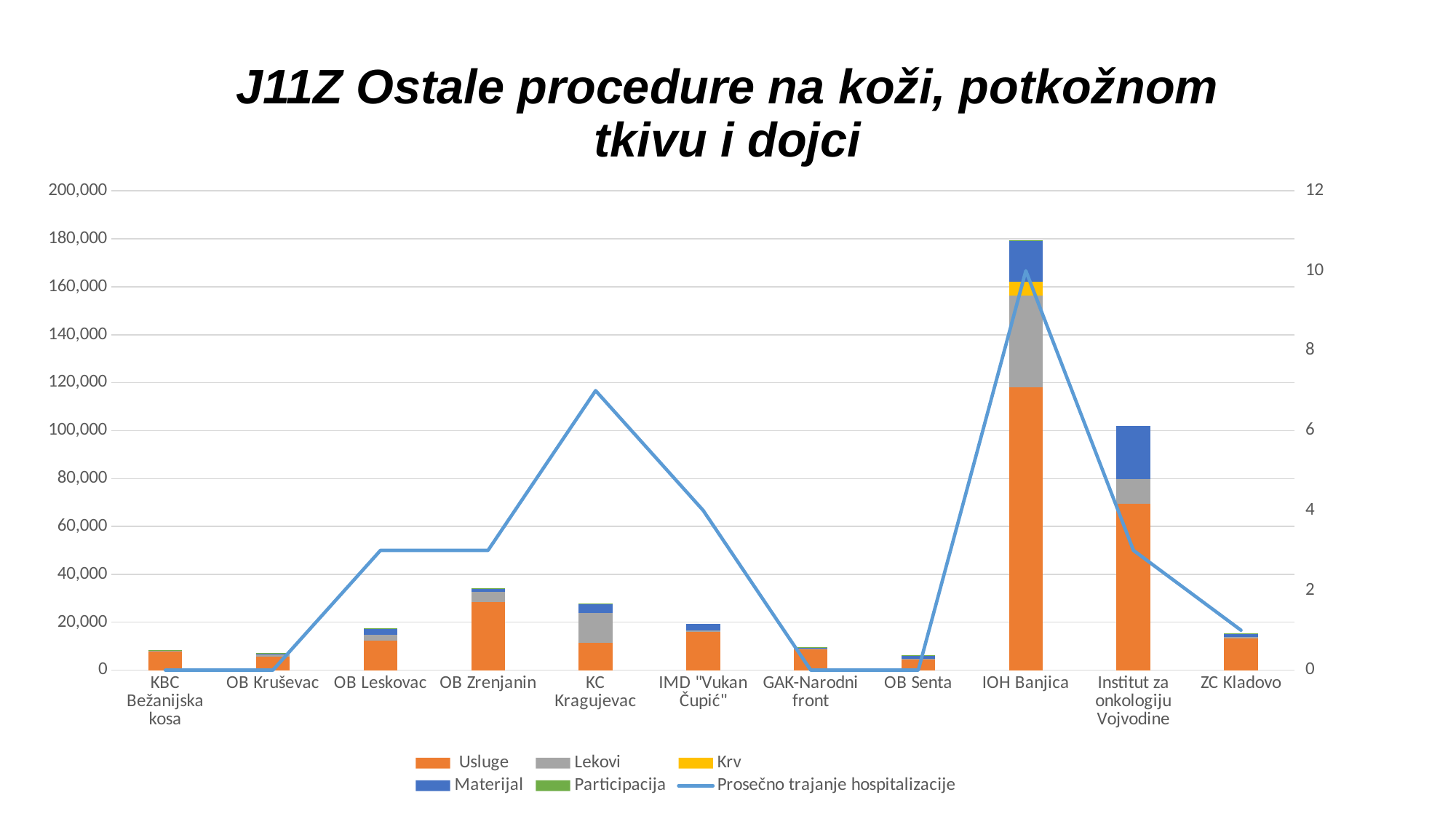
Is the total stacked bar for IOH Banjica greater or less than 160,000? greater What is the title of the chart? J11Z Ostale procedure na koži, potkožnom tkivu i dojci Which hospital has the highest total stacked bar? IOH Banjica Which has the larger total stacked bar, IOH Banjica or Institut za onkologiju Vojvodine? IOH Banjica How many series does the legend list? 6 Is the total stacked bar for OB Zrenjanin greater or less than 40,000? less Which colour represents the Usluge series? Orange Is the Prosečno trajanje hospitalizacije value for ZC Kladovo greater or less than 2? less How many hospitals (categories) are shown on the x axis? 11 What kind of chart is this? Stacked bar chart with a line